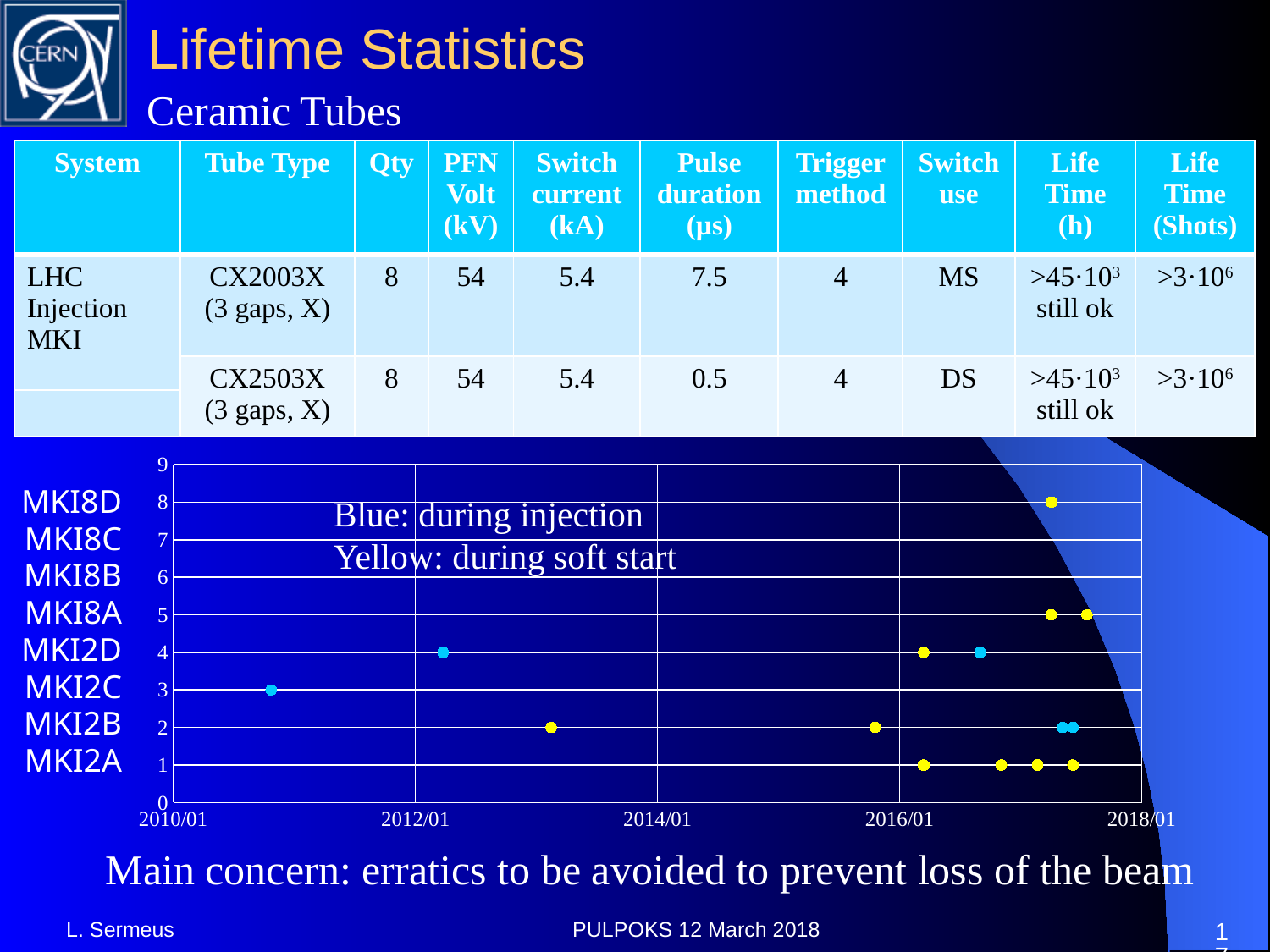
What kind of chart is shown on the slide? scatter chart What is the first date label shown on the x axis of the chart? 2010/01 According to the chart's legend text, what do the blue points represent? during injection How many magnet labels (MKI...) are listed along the y axis of the chart? 8 According to the chart's legend text, what do the yellow points represent? during soft start How many events are plotted for MKI2D? 3 Which magnet has the earliest plotted event in the chart? MKI2C Is the plotted event for MKI8D before or after 2016/01? after What is the last date label shown on the x axis of the chart? 2018/01 How many events are plotted for MKI8B? 0 Is the earliest plotted event (for MKI2C) before or after 2012/01? before What is the highest tick value shown on the y axis of the chart? 9